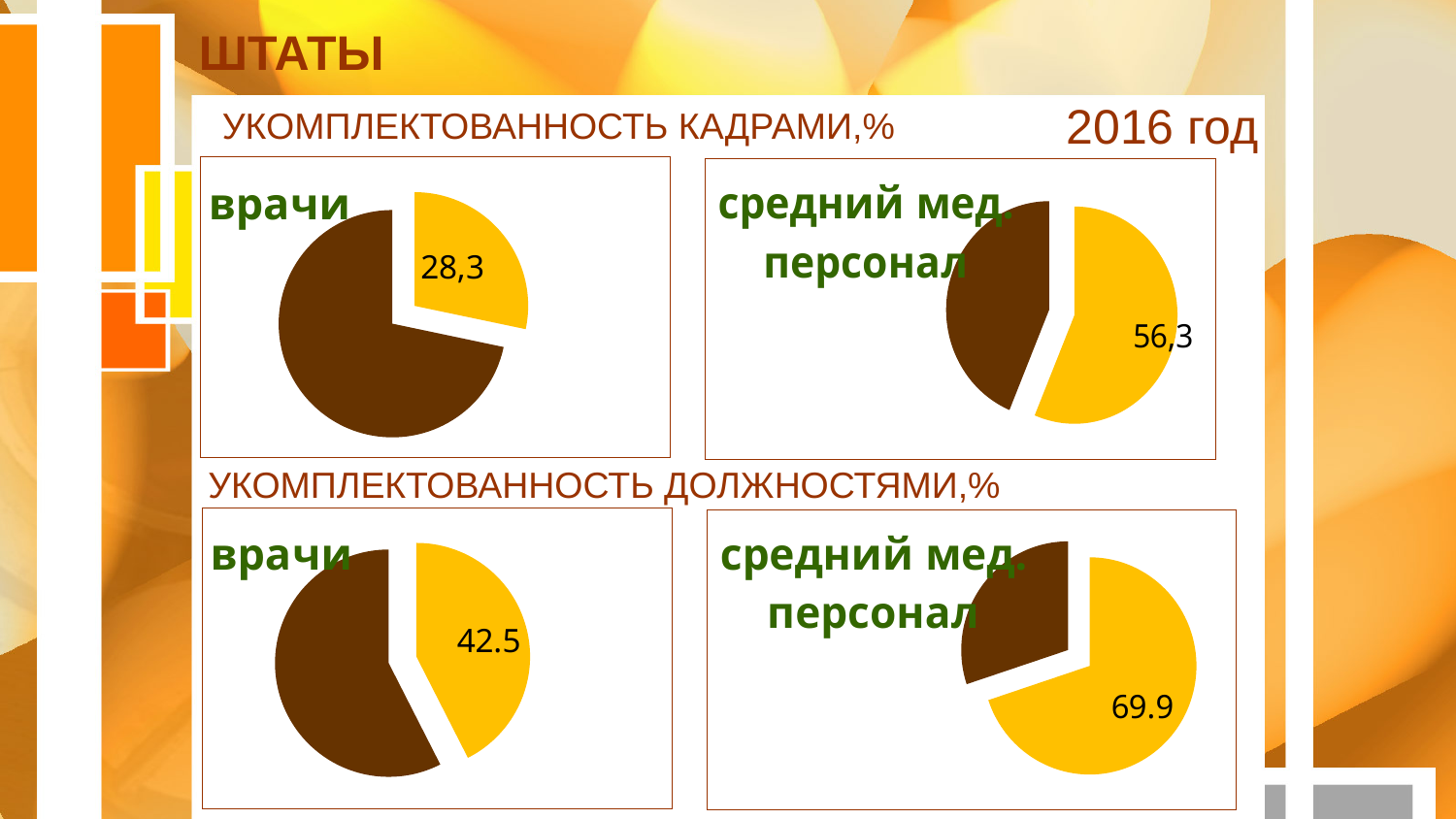
Across the four pie charts on the slide, which chart has the highest labeled value? средний мед. персонал, УКОМПЛЕКТОВАННОСТЬ ДОЛЖНОСТЯМИ,% Which labeled value is larger: врачи in the bottom-left chart (УКОМПЛЕКТОВАННОСТЬ ДОЛЖНОСТЯМИ,%) or средний мед. персонал in the bottom-right chart? средний мед. персонал How many slices does the bottom-right pie chart (средний мед. персонал, УКОМПЛЕКТОВАННОСТЬ ДОЛЖНОСТЯМИ,%) have? 2 What year is shown on the slide for these charts? 2016 год In the top-right pie chart (средний мед. персонал, УКОМПЛЕКТОВАННОСТЬ КАДРАМИ,%), what value is printed on the yellow slice? 56,3 In the bottom-left pie chart (врачи, УКОМПЛЕКТОВАННОСТЬ ДОЛЖНОСТЯМИ,%), what value is printed on the yellow slice? 42.5 Across the four pie charts on the slide, which chart has the lowest labeled value? врачи, УКОМПЛЕКТОВАННОСТЬ КАДРАМИ,% In the bottom-right pie chart (средний мед. персонал, УКОМПЛЕКТОВАННОСТЬ ДОЛЖНОСТЯМИ,%), what value is printed on the yellow slice? 69.9 In the top-left pie chart (врачи, УКОМПЛЕКТОВАННОСТЬ КАДРАМИ,%), what value is printed on the yellow slice? 28,3 In the top-left pie chart (врачи, УКОМПЛЕКТОВАННОСТЬ КАДРАМИ,%), which slice is larger: the yellow slice or the brown slice? brown Which labeled value is larger: врачи in the top-left chart (УКОМПЛЕКТОВАННОСТЬ КАДРАМИ,%) or средний мед. персонал in the top-right chart? средний мед. персонал What kind of chart is used for врачи under УКОМПЛЕКТОВАННОСТЬ КАДРАМИ,%? pie chart